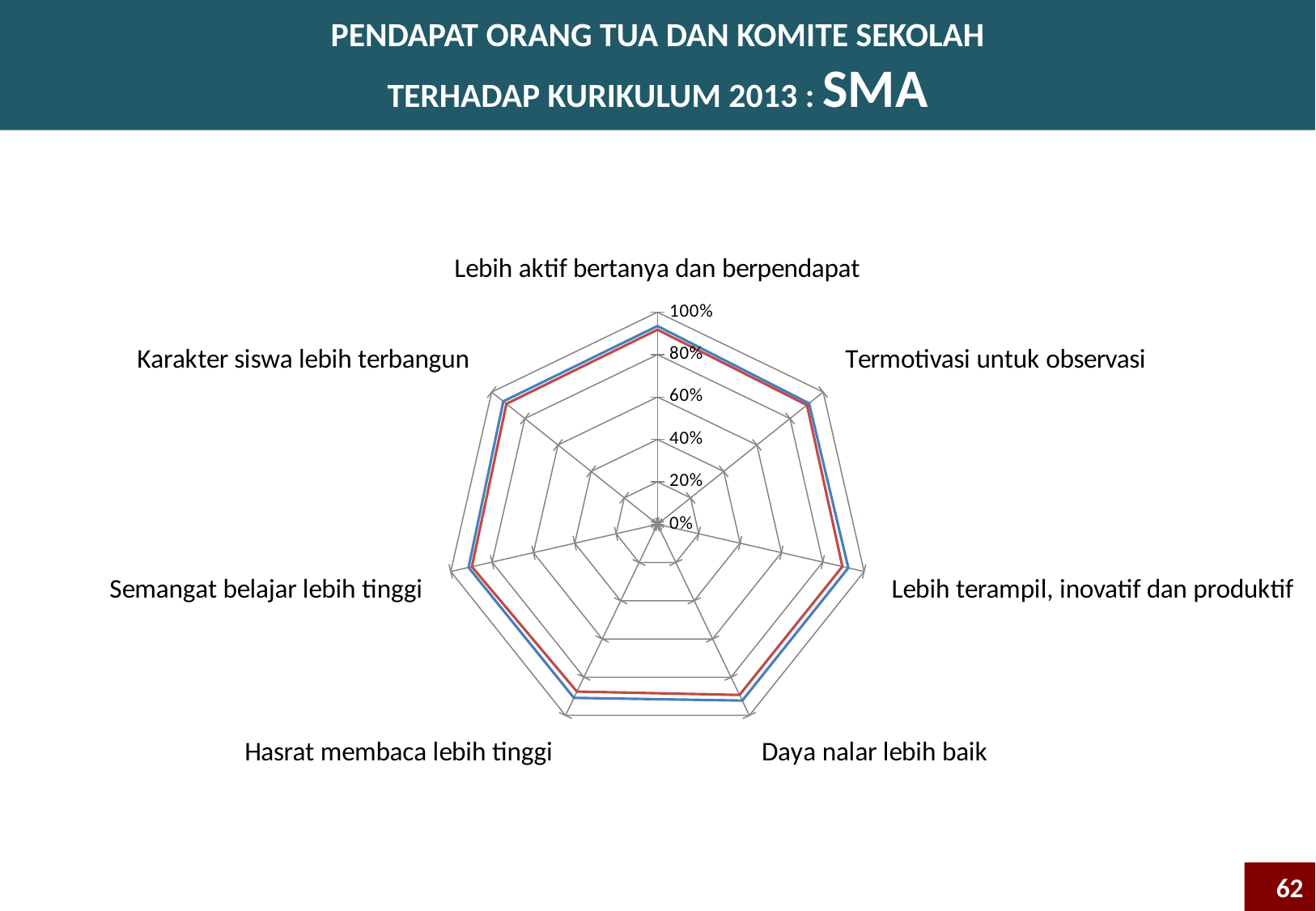
Is the value for "Karakter siswa lebih terbangun" greater or less than 100%? less How many categories (axes) does the radar chart have? 7 Is the value for "Termotivasi untuk observasi" greater or less than 80%? greater What is the title of the slide containing the radar chart? PENDAPAT ORANG TUA DAN KOMITE SEKOLAH TERHADAP KURIKULUM 2013 : SMA How many data series (lines) are plotted on the radar chart? 2 Is the value for "Lebih terampil, inovatif dan produktif" greater or less than 80%? greater What is the maximum value shown on the radar chart's axis scale? 100% What kind of chart is shown on the slide? radar chart